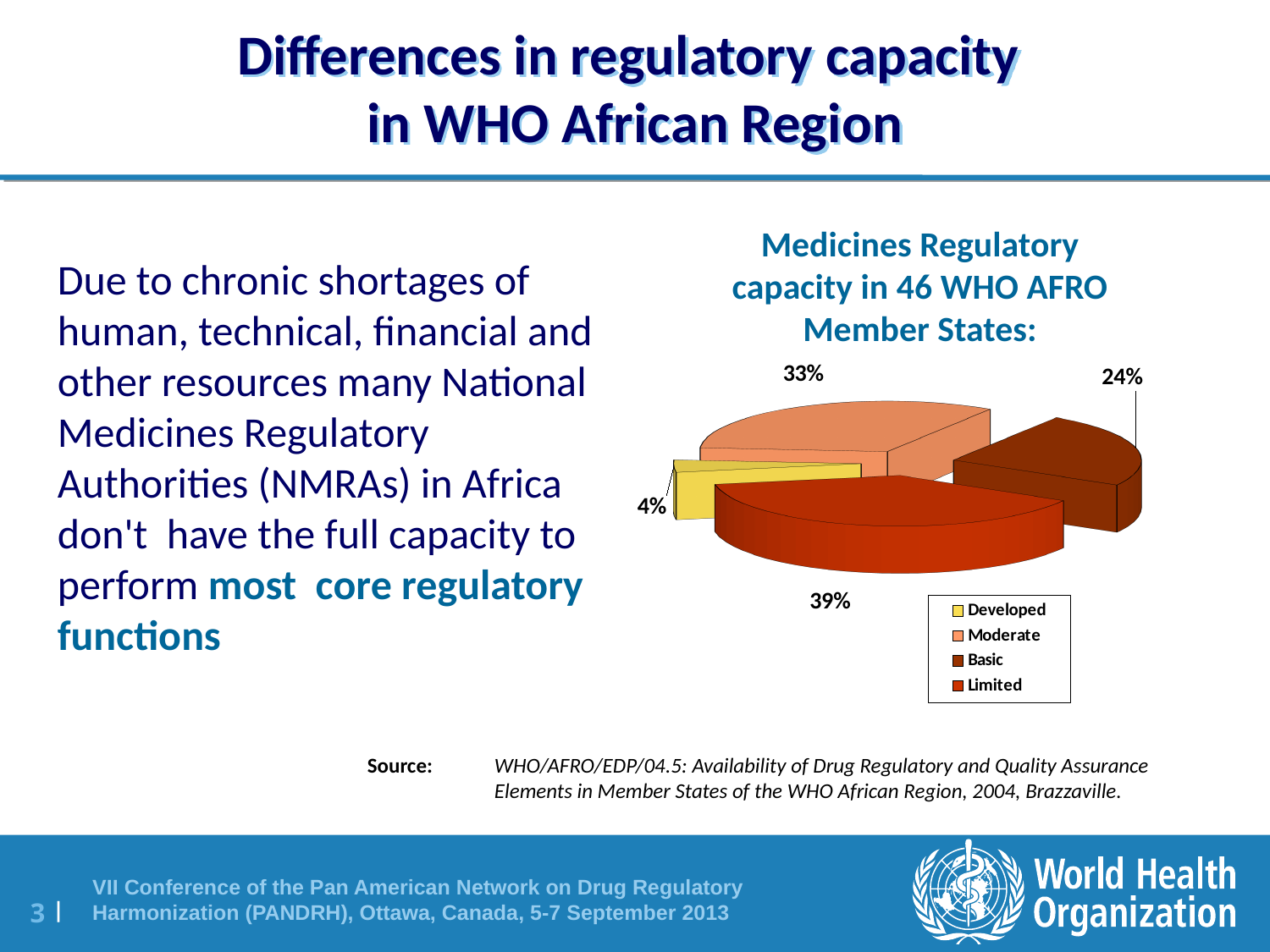
Which category has the largest slice of the pie? Limited How many categories does the legend of the pie chart list? 4 Which slice is larger, Basic or Moderate? Moderate What share of the pie is labelled Developed? 4% What is the difference in percentage points between the Limited and Moderate slices? 6 What is the title of the chart? Medicines Regulatory capacity in 46 WHO AFRO Member States: Which category has the smallest slice of the pie? Developed What kind of chart is shown on the slide? Pie chart What share of the pie is labelled Moderate? 33% What share of the pie is labelled Basic? 24% Which legend entry is shown in yellow? Developed